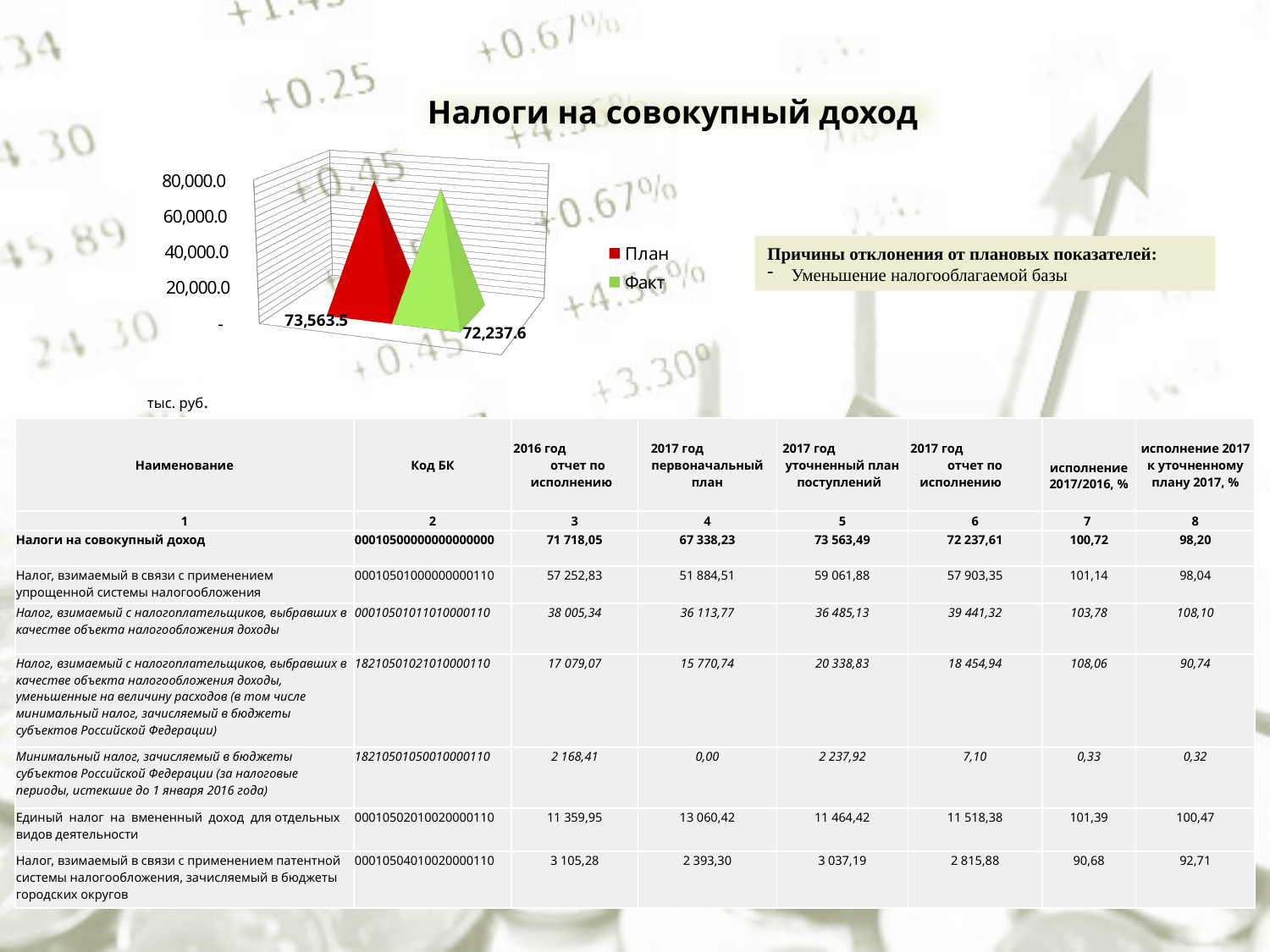
What is the title of the slide above the chart? Налоги на совокупный доход Which series has the higher value on the chart, План or Факт? План What is the value of the Факт series on the chart? 72,237.6 Is the value for План greater or less than 80,000.0? less What is the value of the План series on the chart? 73,563.5 What is the difference between the План value and the Факт value on the chart? 1,325.9 What kind of chart is shown on the slide? 3D pyramid chart Is the value for Факт greater or less than 60,000.0? greater What is the highest value shown on the chart's vertical axis? 80,000.0 What colour represents the План series on the chart? red How many series does the chart legend list? 2 Which series has the lowest value on the chart? Факт